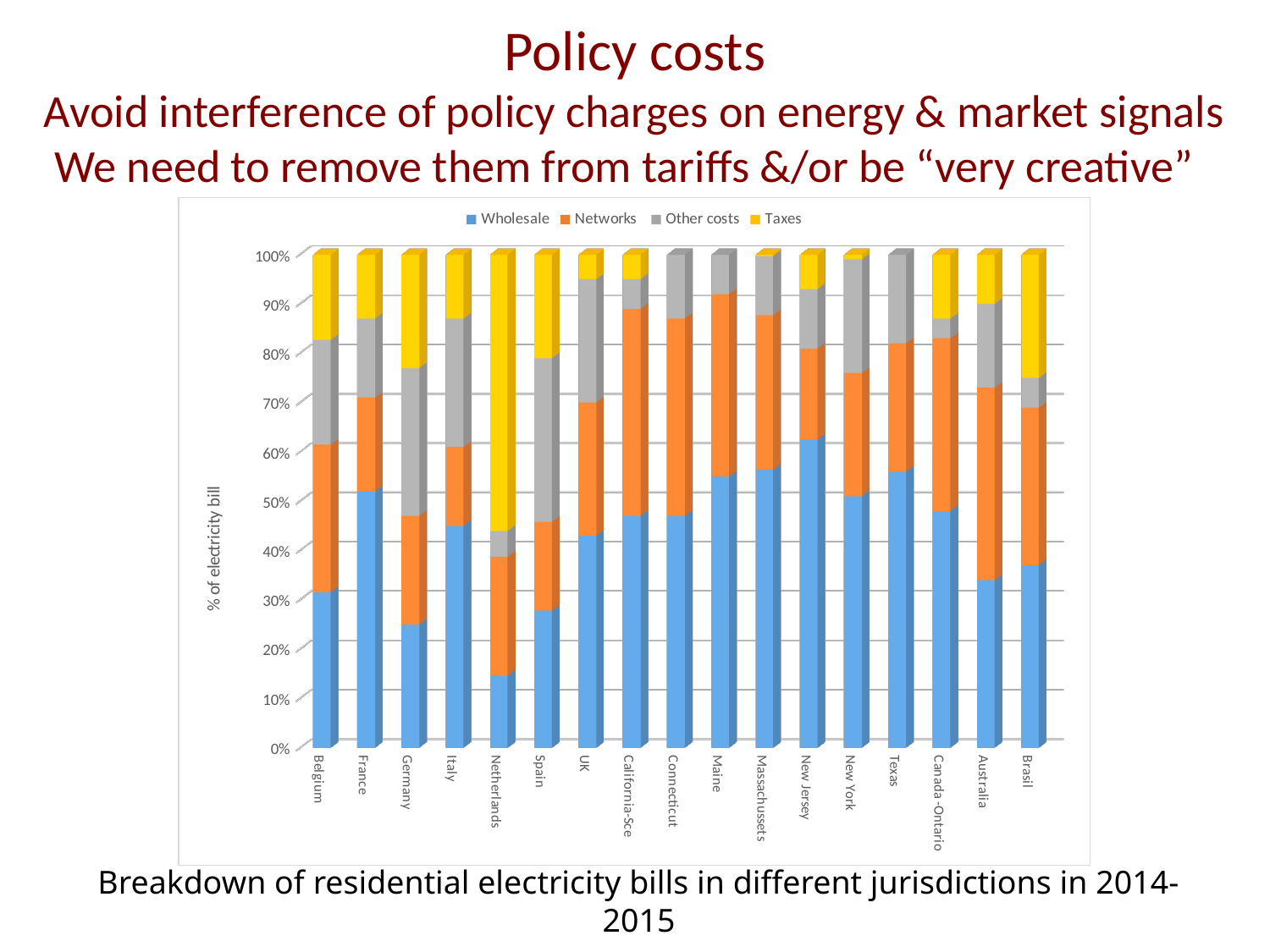
Is the Wholesale share for Netherlands greater or less than 20%? less What kind of chart is shown on the slide? Stacked bar chart Is the Wholesale share for Germany greater or less than 30%? less Which jurisdiction has the lowest Wholesale share of the electricity bill? Netherlands Which has a larger Wholesale share, Germany or Netherlands? Germany Which jurisdiction has the largest Taxes share of the electricity bill? Netherlands How many jurisdictions are shown along the x axis? 17 Which jurisdiction has the highest Wholesale share of the electricity bill? New Jersey Is the Wholesale share for Massachussets greater or less than 50%? greater What is the label on the vertical axis of the chart? % of electricity bill How many series does the legend list? 4 Which has a larger Taxes share, Netherlands or Brasil? Netherlands